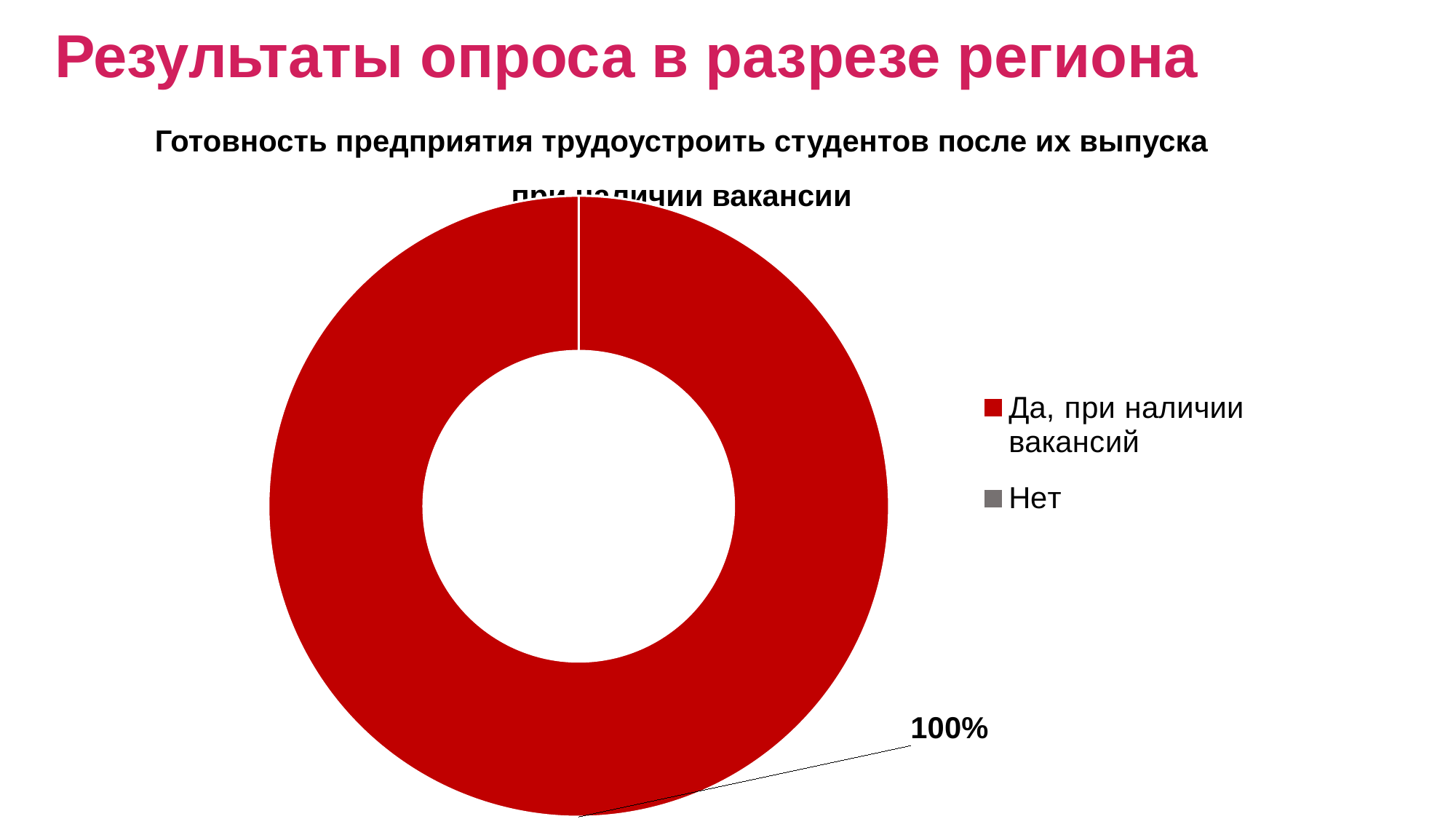
What is the value shown for "Да, при наличии вакансий" in the chart? 100% What colour represents "Да, при наличии вакансий" in the chart? Red What is the title of the chart? Готовность предприятия трудоустроить студентов после их выпуска при наличии вакансии How many entries does the chart legend list? 2 What share of the chart does the "Да, при наличии вакансий" slice take up? 100% Which of the two legend categories is larger, "Да, при наличии вакансий" or "Нет"? Да, при наличии вакансий Which category has the largest share in the chart? Да, при наличии вакансий What kind of chart is shown on the slide? Doughnut (pie) chart